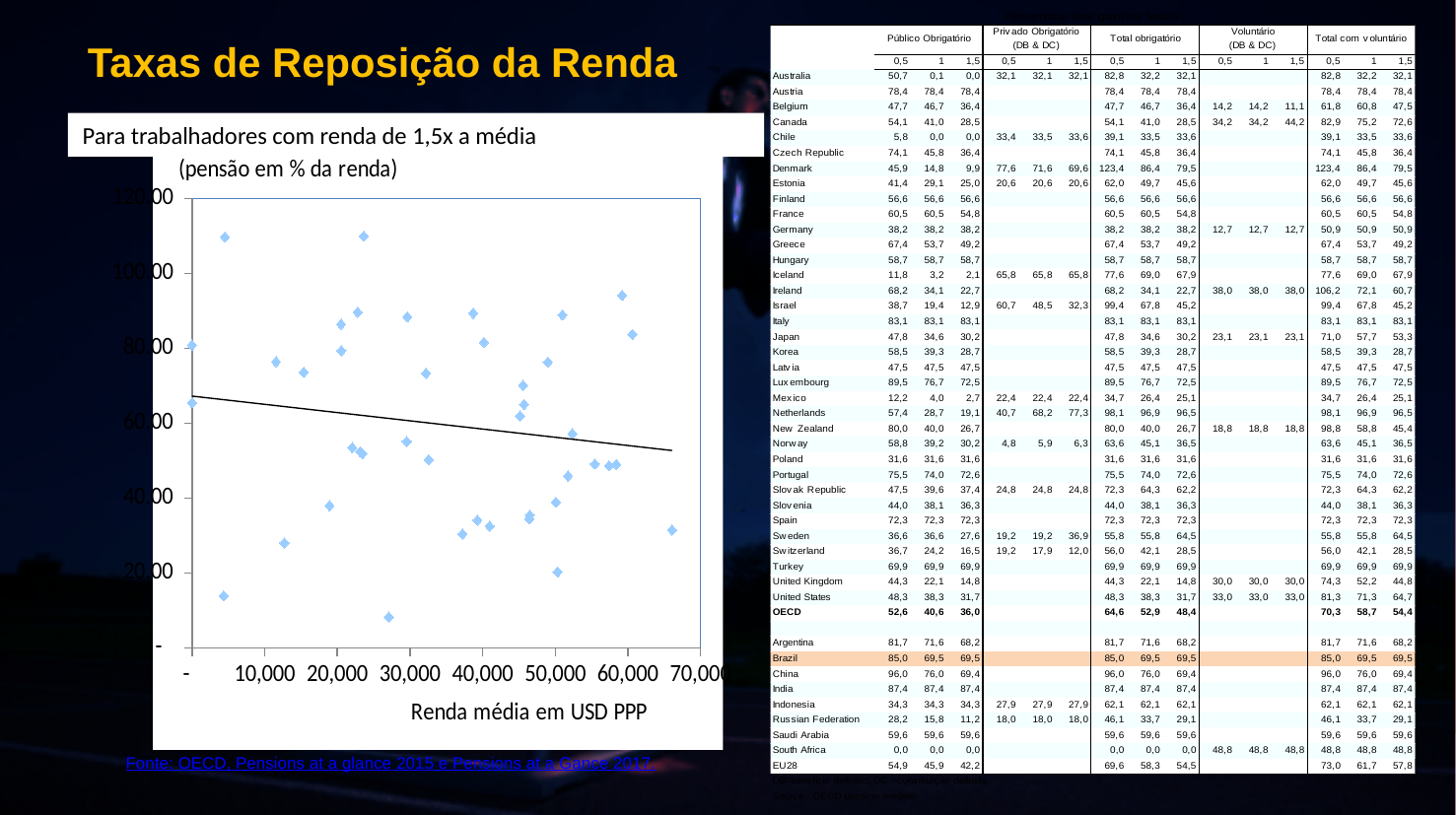
According to the chart subtitle, in what unit is the pension expressed? % da renda Is the x-axis value of the rightmost point in the scatter chart greater or less than 60,000? greater Does the trend line in the scatter chart rise or fall as income (x axis) increases? fall Is the value of the trend line at the left edge of the scatter chart greater or less than 60? greater What is the title of the x axis of the scatter chart? Renda média em USD PPP Is the lowest plotted point in the scatter chart greater or less than 20? less What kind of chart is shown on the left of the slide? scatter chart